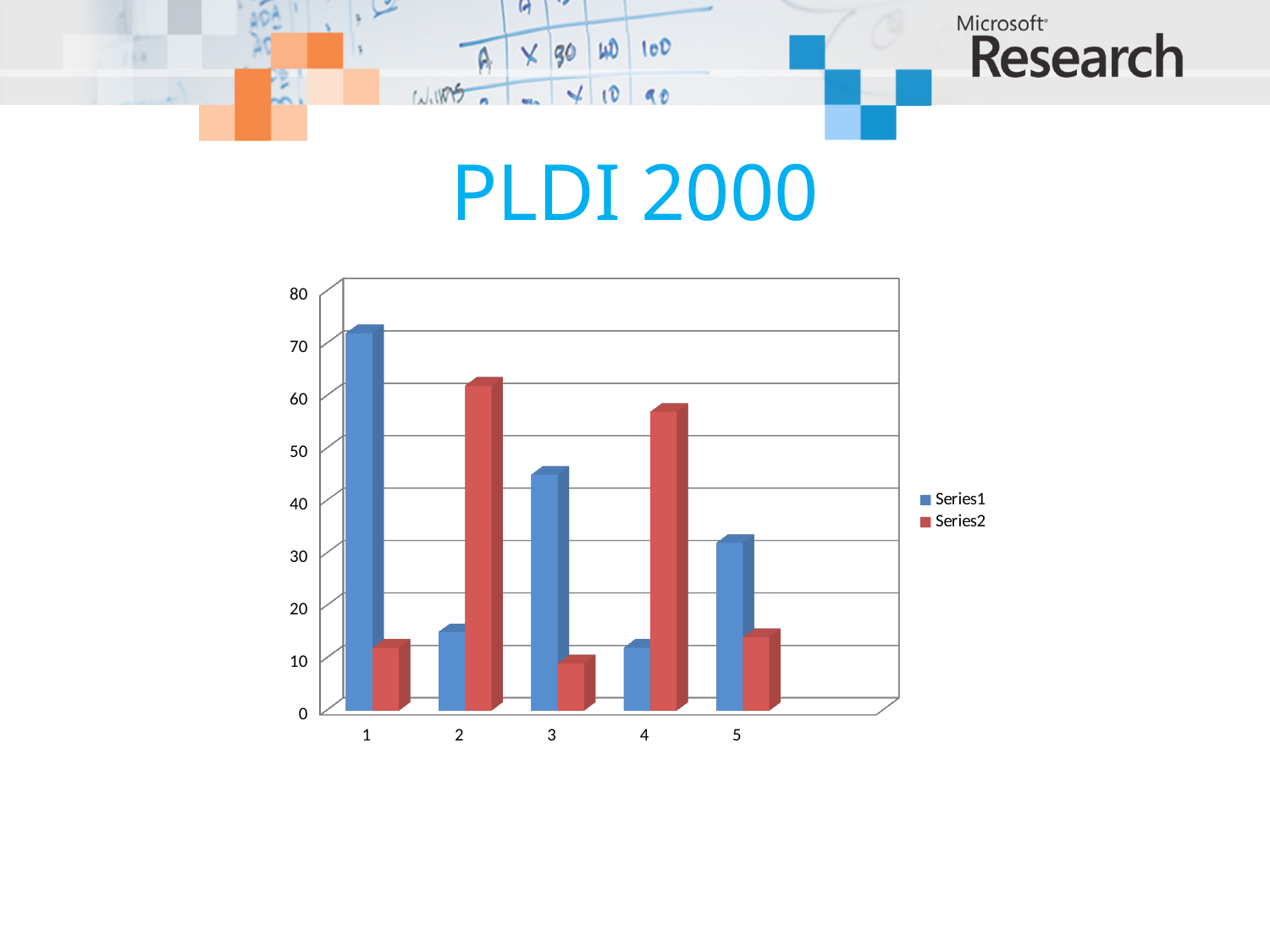
Is the value for Series1 at category 5 greater or less than 40? less What is the title shown above the chart? PLDI 2000 Which category has the highest value for Series2? 2 How many categories are shown on the x axis of the chart? 5 What kind of chart is shown on the slide? bar chart At category 2, which series has the larger value, Series1 or Series2? Series2 How many series does the chart's legend list? 2 Is the value for Series1 at category 1 greater or less than 60? greater Is the value for Series2 at category 4 greater or less than 50? greater Which category has the lowest value for Series2? 3 At category 3, which series has the larger value, Series1 or Series2? Series1 Which category has the highest value for Series1? 1